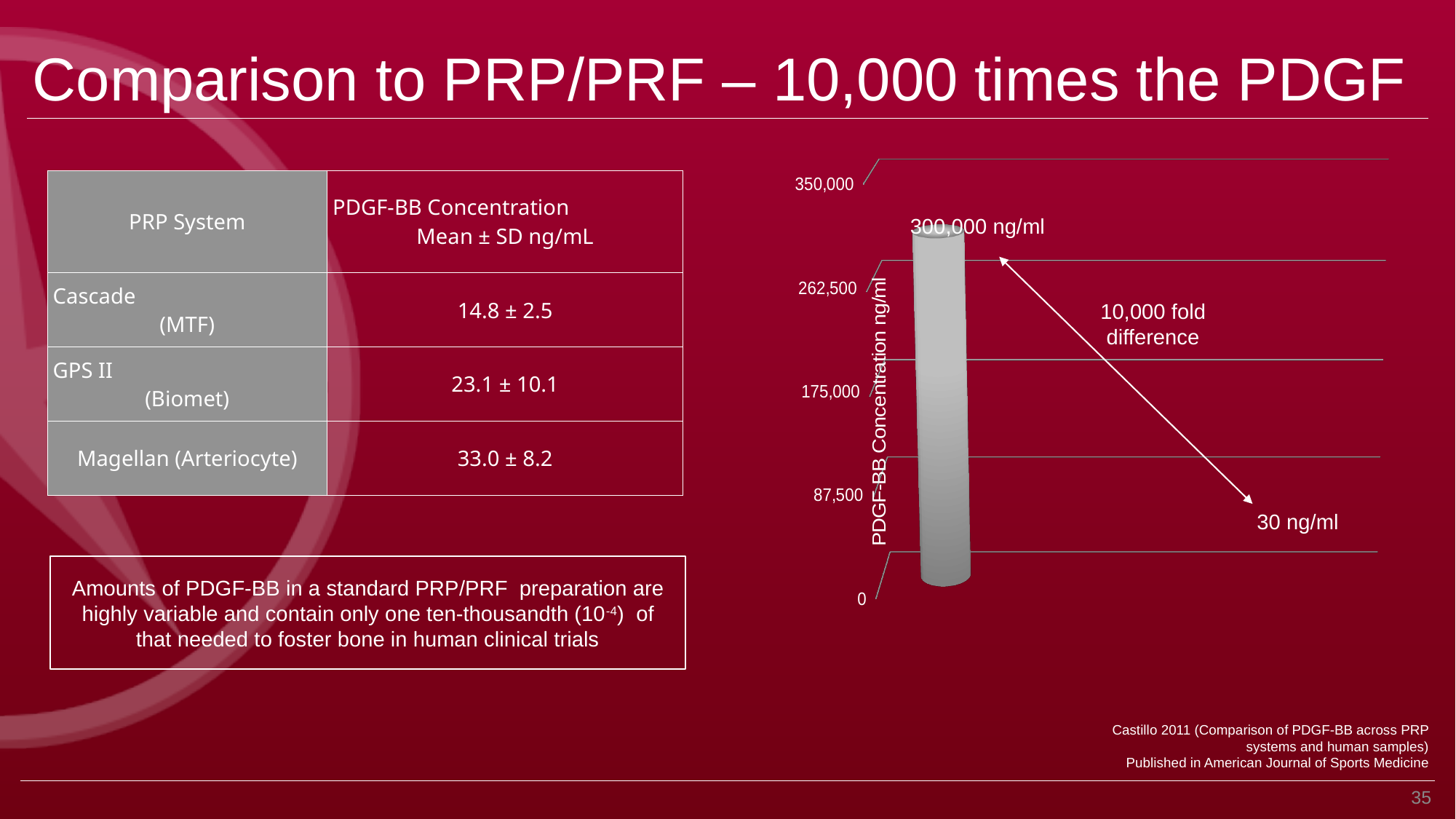
What value is printed as the data label on the bar in the chart? 300,000 ng/ml Which is larger in the chart: the bar value of 300,000 ng/ml or the annotated value of 30 ng/ml? 300,000 ng/ml According to the annotation on the chart, what is the fold difference between the two values? 10,000 fold difference What kind of chart is shown on the right side of the slide? bar chart Is the value of the bar in the chart greater or less than 350,000? less How many bars are plotted in the chart? 1 What value is printed at the lower end of the arrow in the chart? 30 ng/ml Is the value of the bar in the chart greater or less than 262,500? greater What is the highest tick value shown on the vertical axis of the chart? 350,000 What is the label of the vertical axis in the chart? PDGF-BB Concentration ng/ml